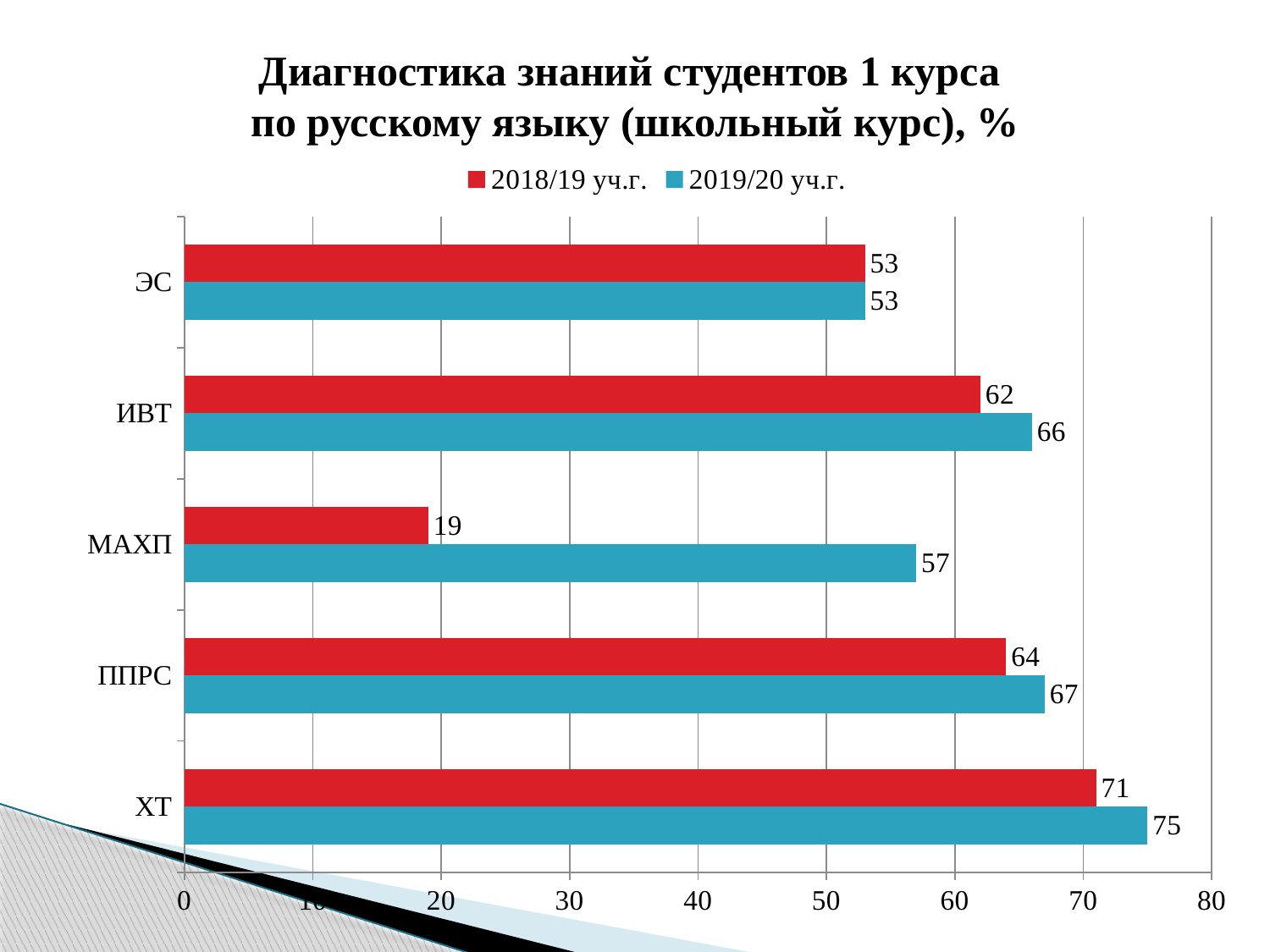
Which category has the lowest value in 2018/19 уч.г.? МАХП Which is larger for ППРС: the 2018/19 уч.г. value or the 2019/20 уч.г. value? 2019/20 уч.г. What kind of chart is shown on the slide? Bar chart What is the value for ХТ in 2019/20 уч.г.? 75 How many series does the legend list? 2 Which colour represents 2019/20 уч.г. in the chart? Blue What is the difference between the 2019/20 уч.г. and 2018/19 уч.г. values for МАХП? 38 What is the value for ИВТ in 2019/20 уч.г.? 66 What is the difference between the 2018/19 уч.г. values for ХТ and ЭС? 18 How many categories are shown on the chart? 5 Which category has the highest value in 2019/20 уч.г.? ХТ What is the value for МАХП in 2018/19 уч.г.? 19